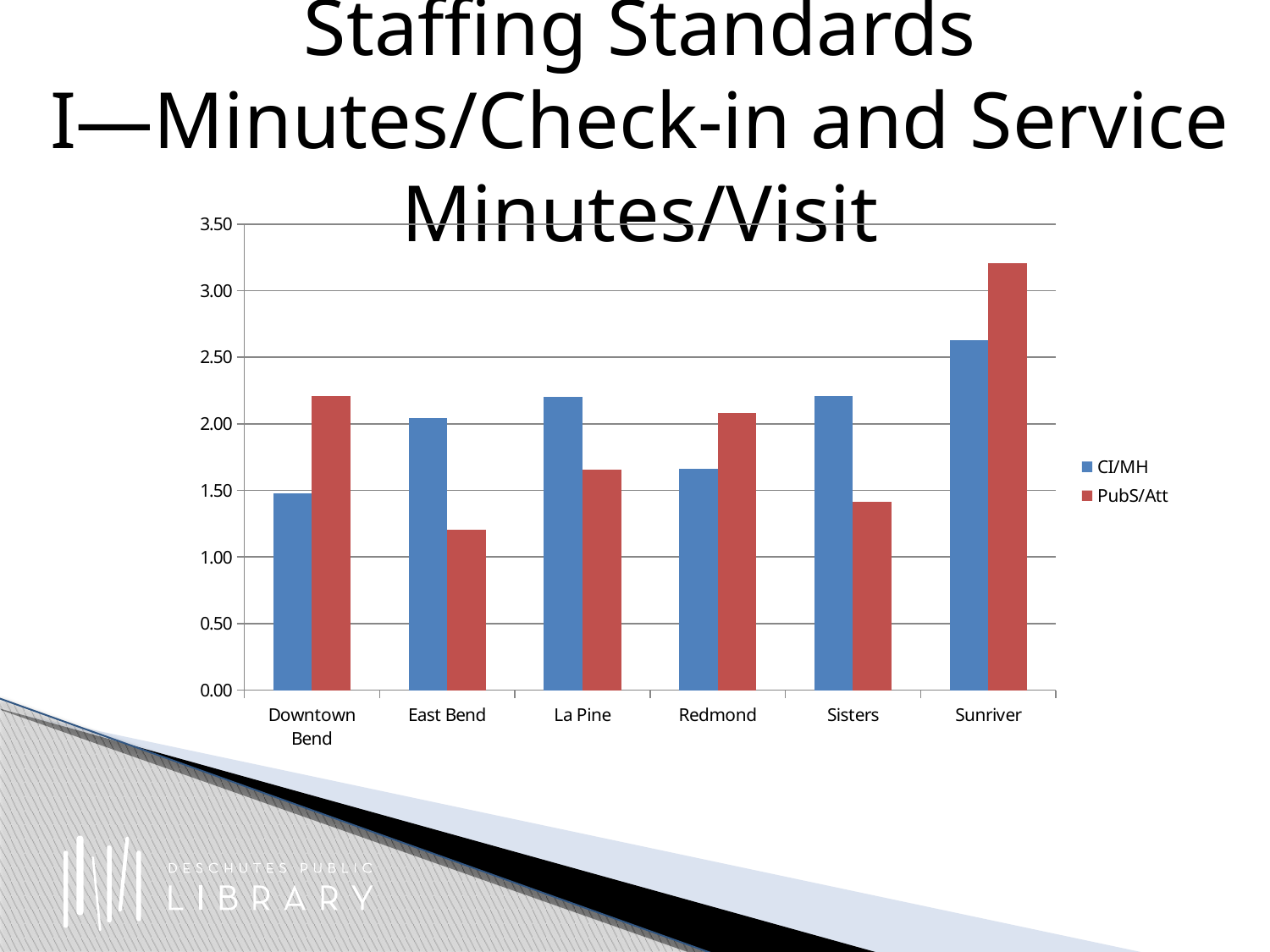
How many branches are shown along the x axis of the chart? 6 Which branch has the lowest PubS/Att value? East Bend How many series does the chart's legend list? 2 What kind of chart is shown on the slide? bar chart Which branch has the highest CI/MH value? Sunriver Is the PubS/Att value for Sunriver greater or less than 3.00? greater Which branch has the highest PubS/Att value? Sunriver For Downtown Bend, which series has the larger value, CI/MH or PubS/Att? PubS/Att Is the PubS/Att value for East Bend greater or less than 1.50? less Is the CI/MH value for Sunriver greater or less than 2.50? greater Which colour represents the PubS/Att series in the legend? red Which branch has the lowest CI/MH value? Downtown Bend